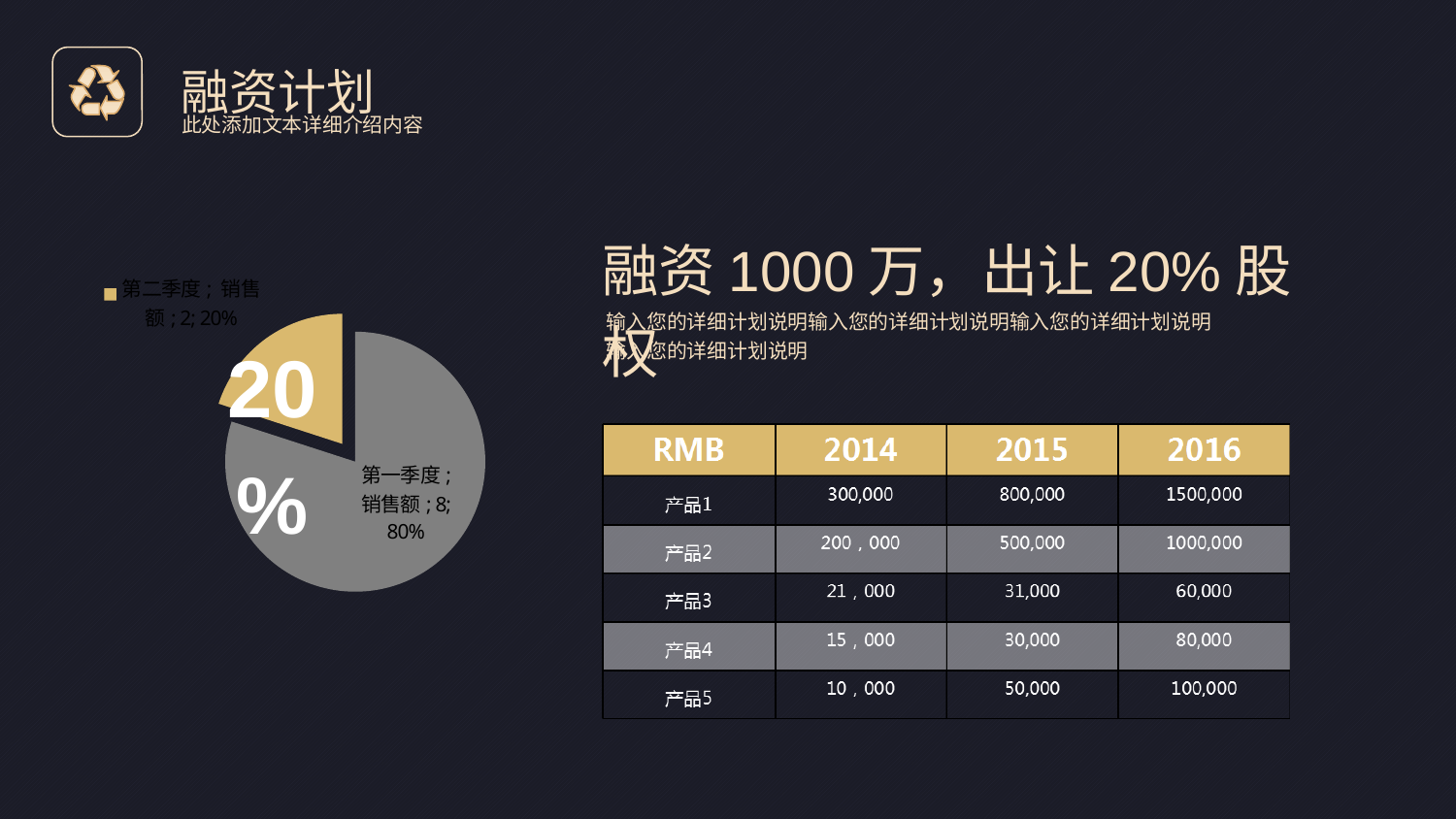
What is the sales value (销售额) labelled for 第二季度 in the pie chart? 2 Which slice of the pie chart is the smallest? 第二季度 How many slices does the pie chart have? 2 What is the sales value (销售额) labelled for 第一季度 in the pie chart? 8 What percentage share does the 第一季度 slice represent in the pie chart? 80% What large number is overlaid on the pie chart? 20% What kind of chart is shown on the left of the slide? pie chart In the pie chart, which is larger: the 第一季度 slice or the 第二季度 slice? 第一季度 What is the difference in percentage points between the 第一季度 and 第二季度 slices of the pie chart? 60% What percentage share does the 第二季度 slice represent in the pie chart? 20% Which slice of the pie chart is the largest? 第一季度 What colour is the 第二季度 slice in the pie chart? gold